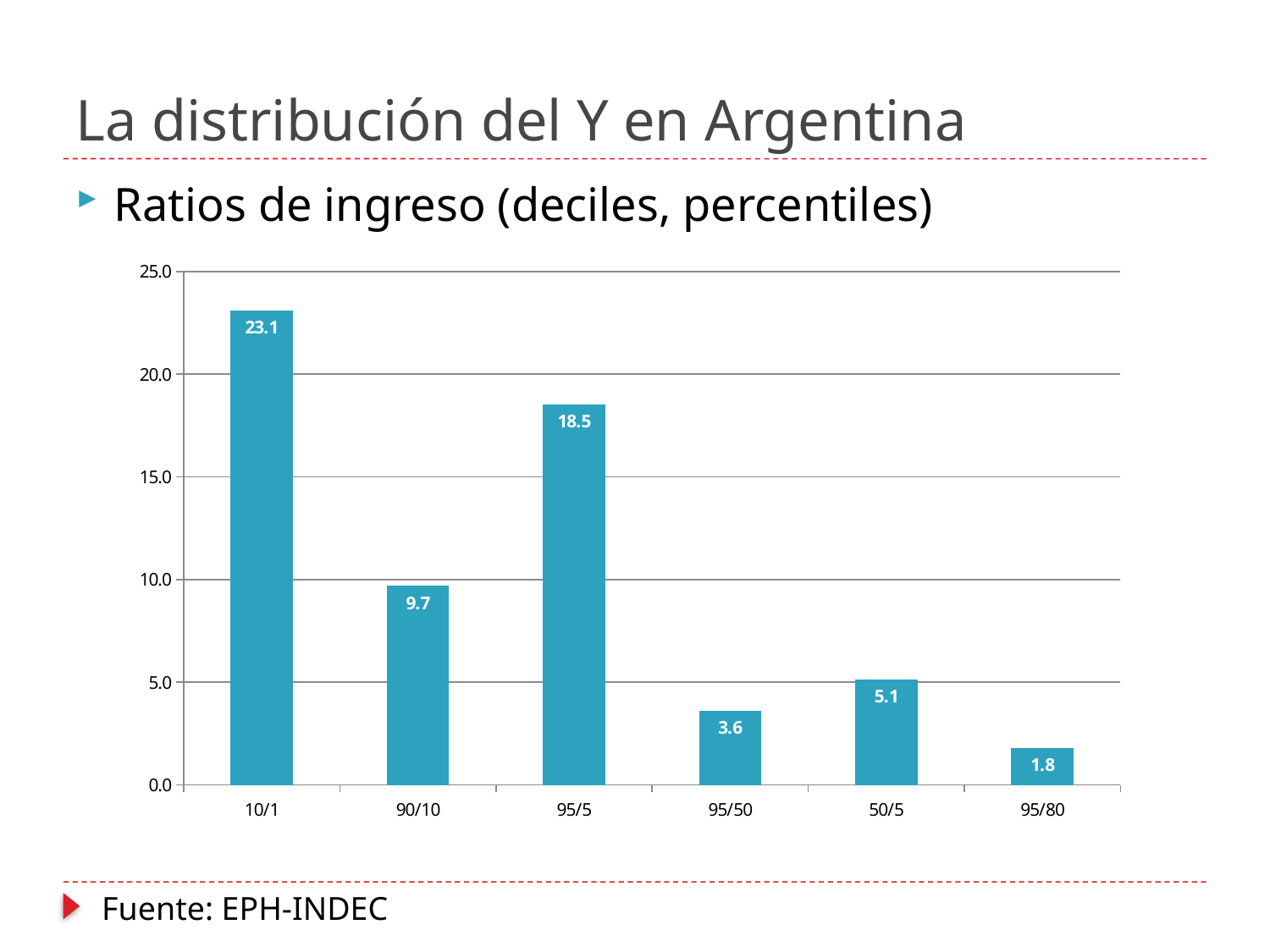
What kind of chart is shown on the slide? bar chart What is the value for the 10/1 ratio? 23.1 Which is larger, the value for 50/5 or the value for 95/50? 50/5 How many categories are shown on the x axis? 6 What source is cited for the chart data? EPH-INDEC What is the difference between the values for 10/1 and 95/5? 4.6 Which category has the highest value? 10/1 What is the value for the 95/80 ratio? 1.8 What is the difference between the values for 90/10 and 50/5? 4.6 Is the value for 90/10 greater or less than 10.0? less What is the value for the 95/50 ratio? 3.6 Which category has the lowest value? 95/80